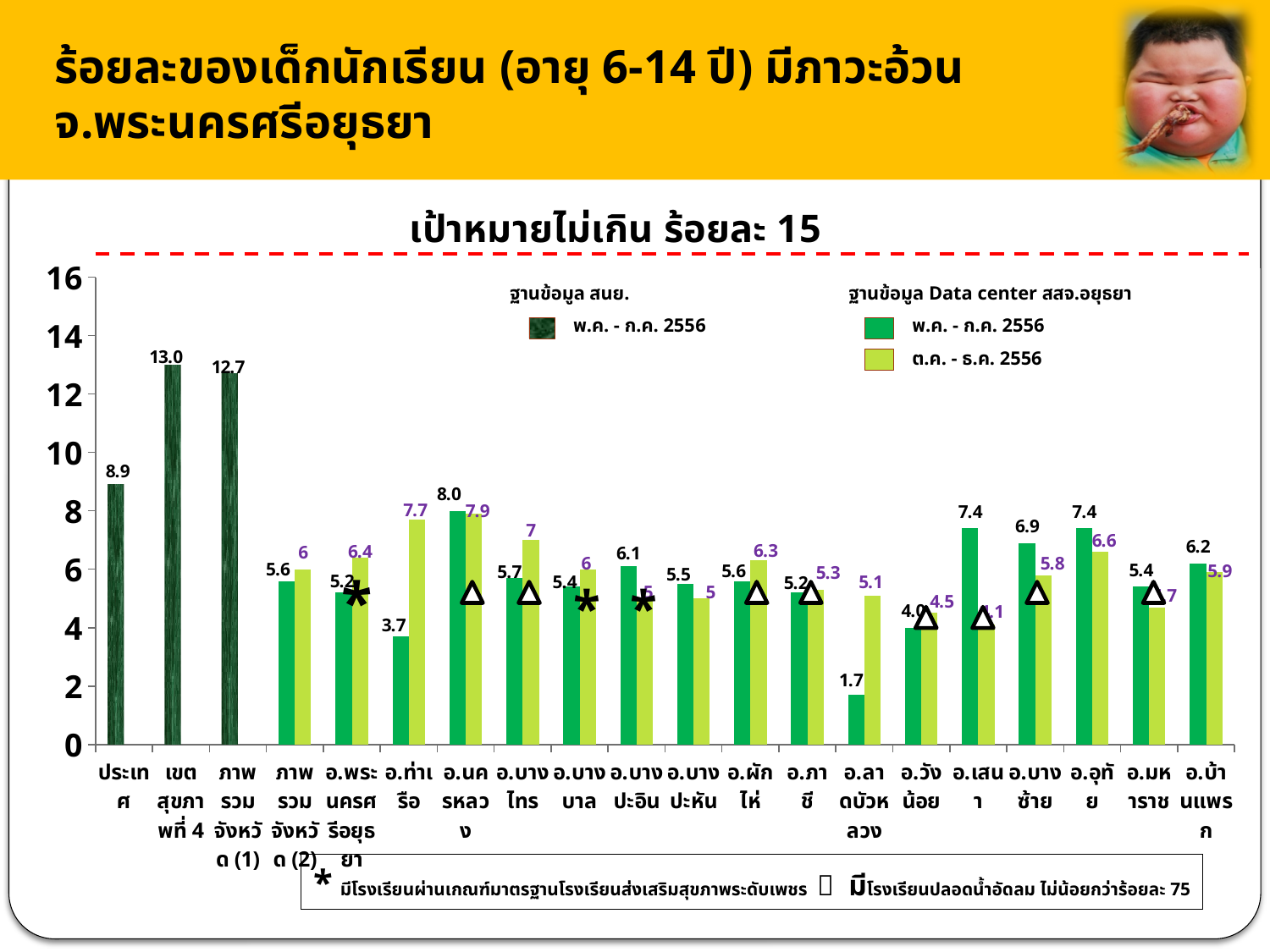
How many categories are shown on the x axis? 20 What is the value shown for เขตสุขภาพที่ 4? 13.0 What kind of chart is shown on the slide? bar chart For อ.เสนา, which period has the larger value: พ.ค. - ก.ค. 2556 or ต.ค. - ธ.ค. 2556? พ.ค. - ก.ค. 2556 How many series does the legend list? 3 What is the ต.ค. - ธ.ค. 2556 value for อ.ท่าเรือ? 7.7 Is the value for ประเทศ greater or less than 10? less What is the พ.ค. - ก.ค. 2556 (Data center สสจ.อยุธยา) value for อ.นครหลวง? 8.0 Which category has the lowest bar on the chart? อ.ลาดบัวหลวง What is the พ.ค. - ก.ค. 2556 (Data center สสจ.อยุธยา) value for อ.ลาดบัวหลวง? 1.7 What is the difference between the ต.ค. - ธ.ค. 2556 value and the พ.ค. - ก.ค. 2556 value for อ.ท่าเรือ? 4.0 Which category has the highest bar on the chart? เขตสุขภาพที่ 4